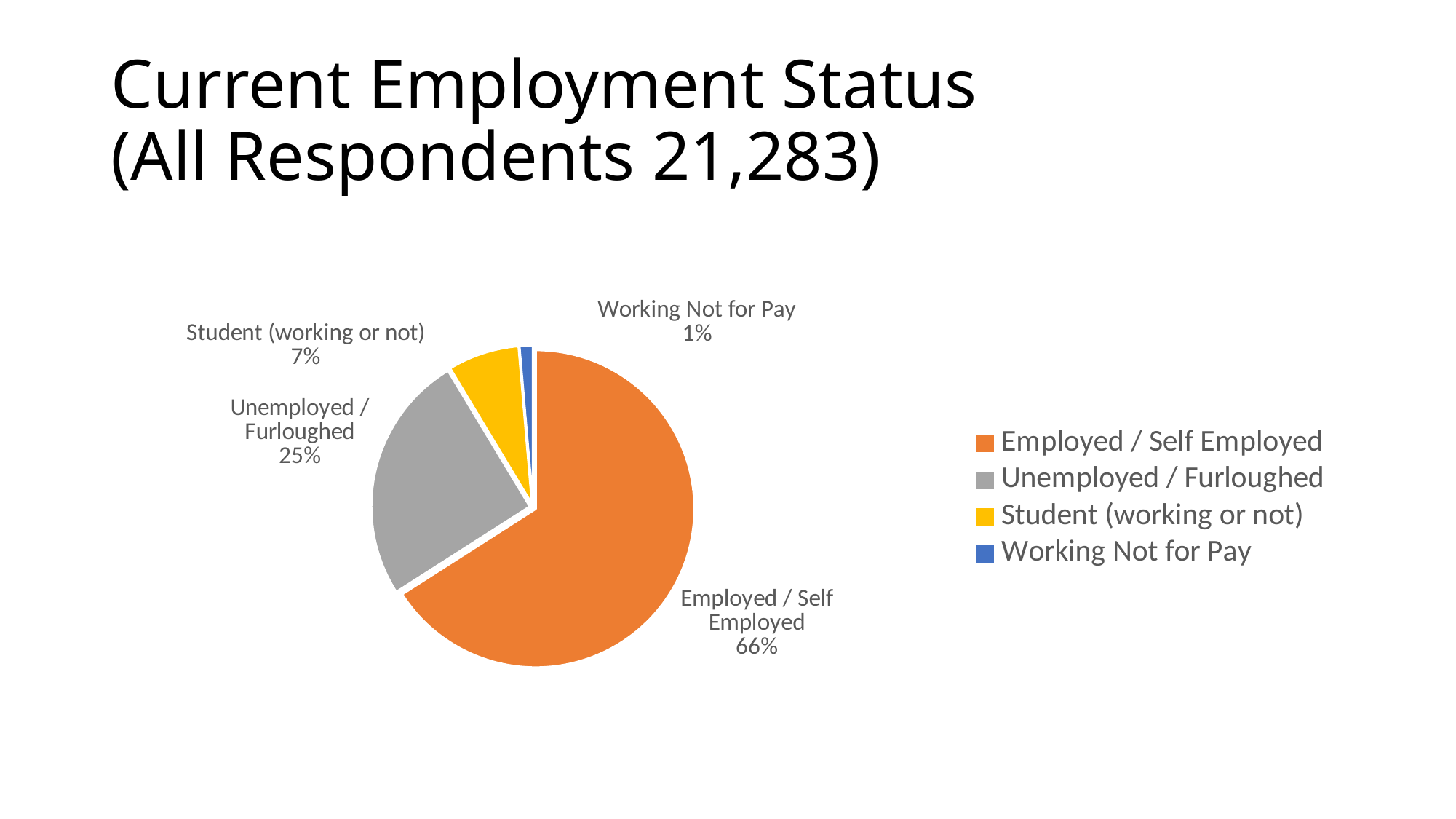
Which is larger: the share for Student (working or not) or the share for Working Not for Pay? Student (working or not) How many categories are shown in the pie chart? 4 What percentage of respondents are Unemployed / Furloughed? 25% What percentage of respondents are Working Not for Pay? 1% What type of chart is shown on the slide? pie chart What is the difference in percentage points between Employed / Self Employed and Unemployed / Furloughed? 41 Which category has the largest share of the pie? Employed / Self Employed What colour is the Unemployed / Furloughed slice? grey What percentage of respondents are Student (working or not)? 7% What percentage of respondents are Employed / Self Employed? 66% Which category has the smallest share of the pie? Working Not for Pay How many respondents does the chart title say were included? 21,283